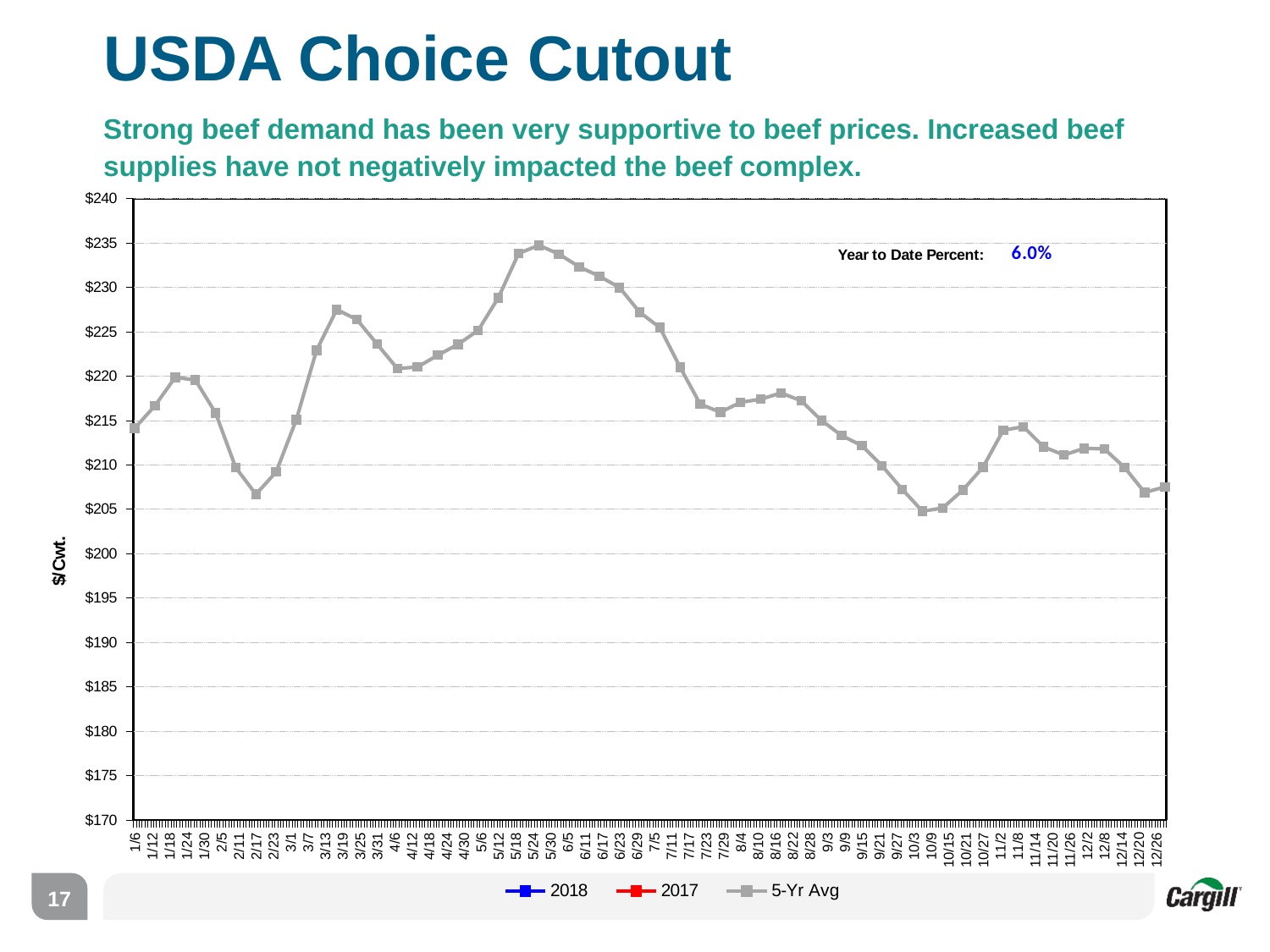
What kind of chart is shown on the slide? line chart Is the 5-Yr Avg value at 10/3 greater or less than $210? less How many series does the legend list? 3 Is the 5-Yr Avg value at 2/17 greater or less than $210? less Around which date does the 5-Yr Avg line reach its highest value? 5/24 Which is larger, the 5-Yr Avg value at 5/24 or at 10/3? 5/24 Is the 5-Yr Avg value at 3/13 greater or less than $225? greater Which series are listed in the legend? 2018, 2017, 5-Yr Avg Does the 5-Yr Avg line rise or fall between 5/24 and 10/3? fall What is the label on the vertical axis? $/Cwt.